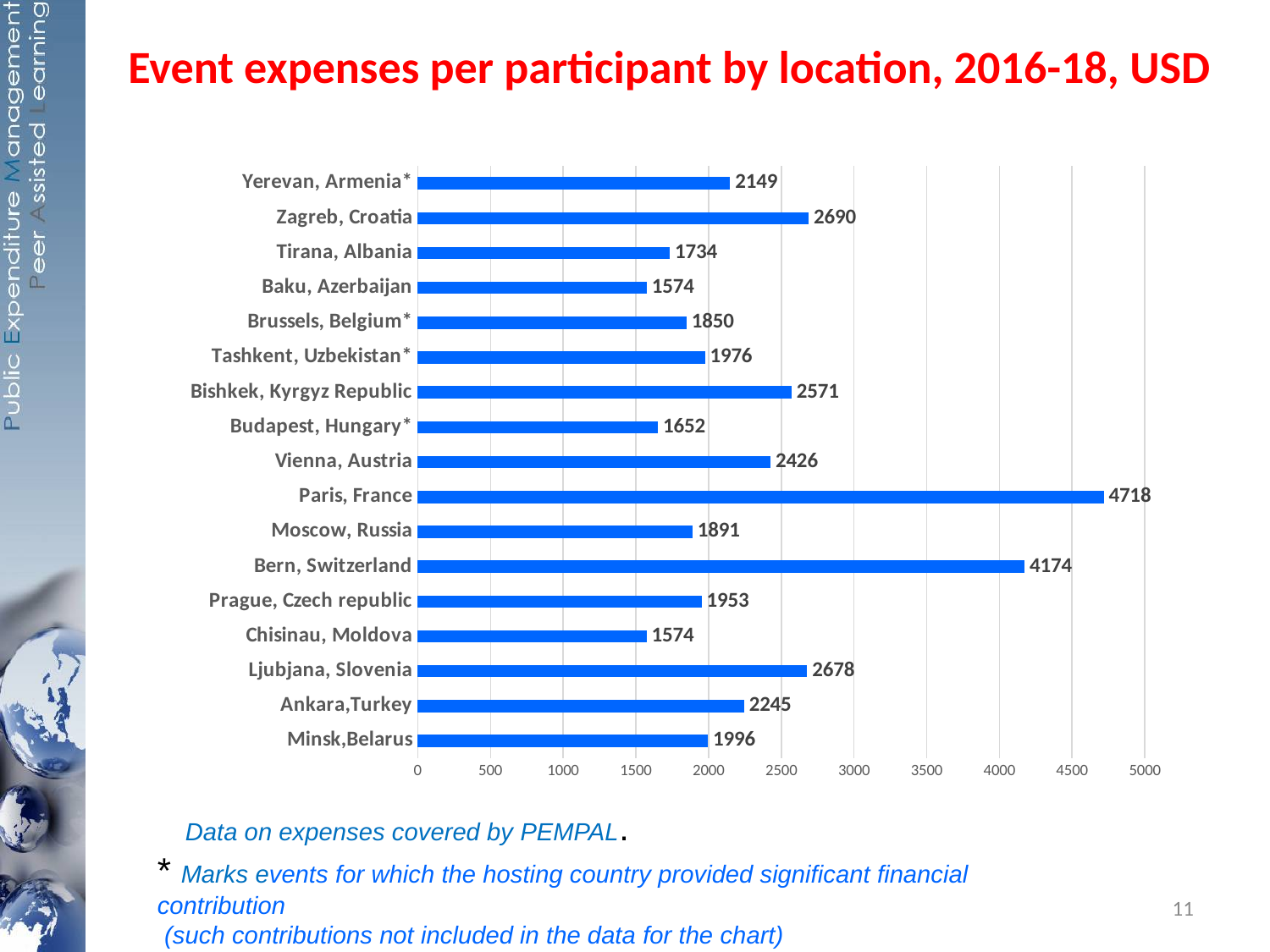
What is the title of the chart on the slide? Event expenses per participant by location, 2016-18, USD What is the value shown for Minsk, Belarus? 1996 What is the value shown for Bishkek, Kyrgyz Republic? 2571 What is the difference between the values for Zagreb, Croatia and Ljubjana, Slovenia? 12 What is the event expense per participant for Paris, France? 4718 Which is larger, the value for Vienna, Austria or the value for Ankara, Turkey? Vienna, Austria Is the value for Bern, Switzerland greater or less than 4000? greater What kind of chart is shown on the slide? Bar chart How many locations are shown in the chart? 17 What is the maximum value shown on the horizontal axis of the chart? 5000 What is the difference between the values for Paris, France and Bern, Switzerland? 544 Which location has the highest event expense per participant? Paris, France